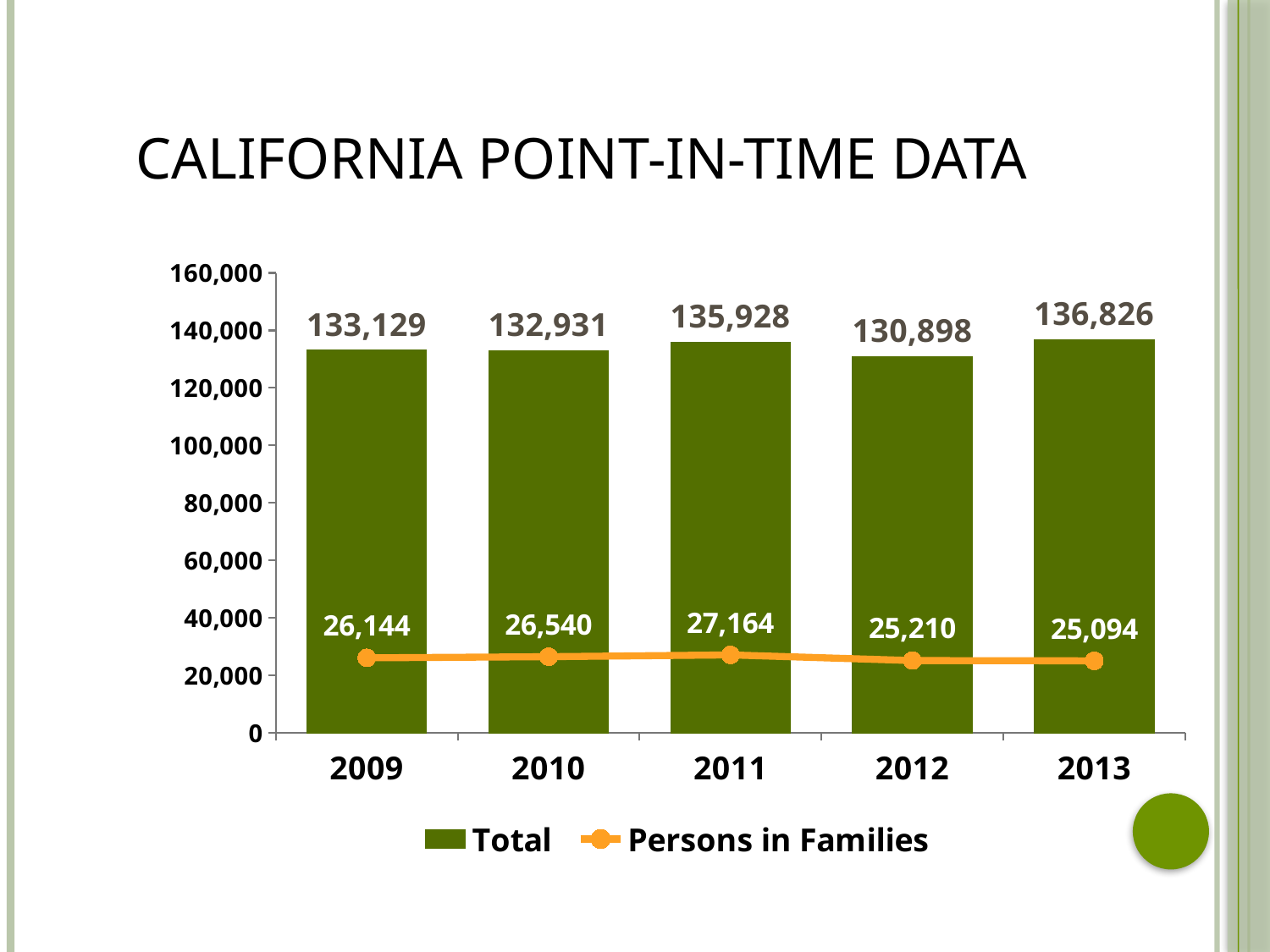
What is the title of the slide? CALIFORNIA POINT-IN-TIME DATA What is the Persons in Families value for 2013? 25,094 Which is larger, the Persons in Families value for 2010 or for 2012? 2010 Which year has the lowest Persons in Families value? 2013 What is the Total value for 2011? 135,928 How many years are shown on the x axis? 5 What kind of chart is shown on the slide? Combined bar and line chart What is the difference between the Total values for 2013 and 2012? 5,928 Which year has the highest Total value? 2013 Which year has the lowest Total value? 2012 Is the Total value for 2012 greater or less than 120,000? greater How many series does the legend list? 2